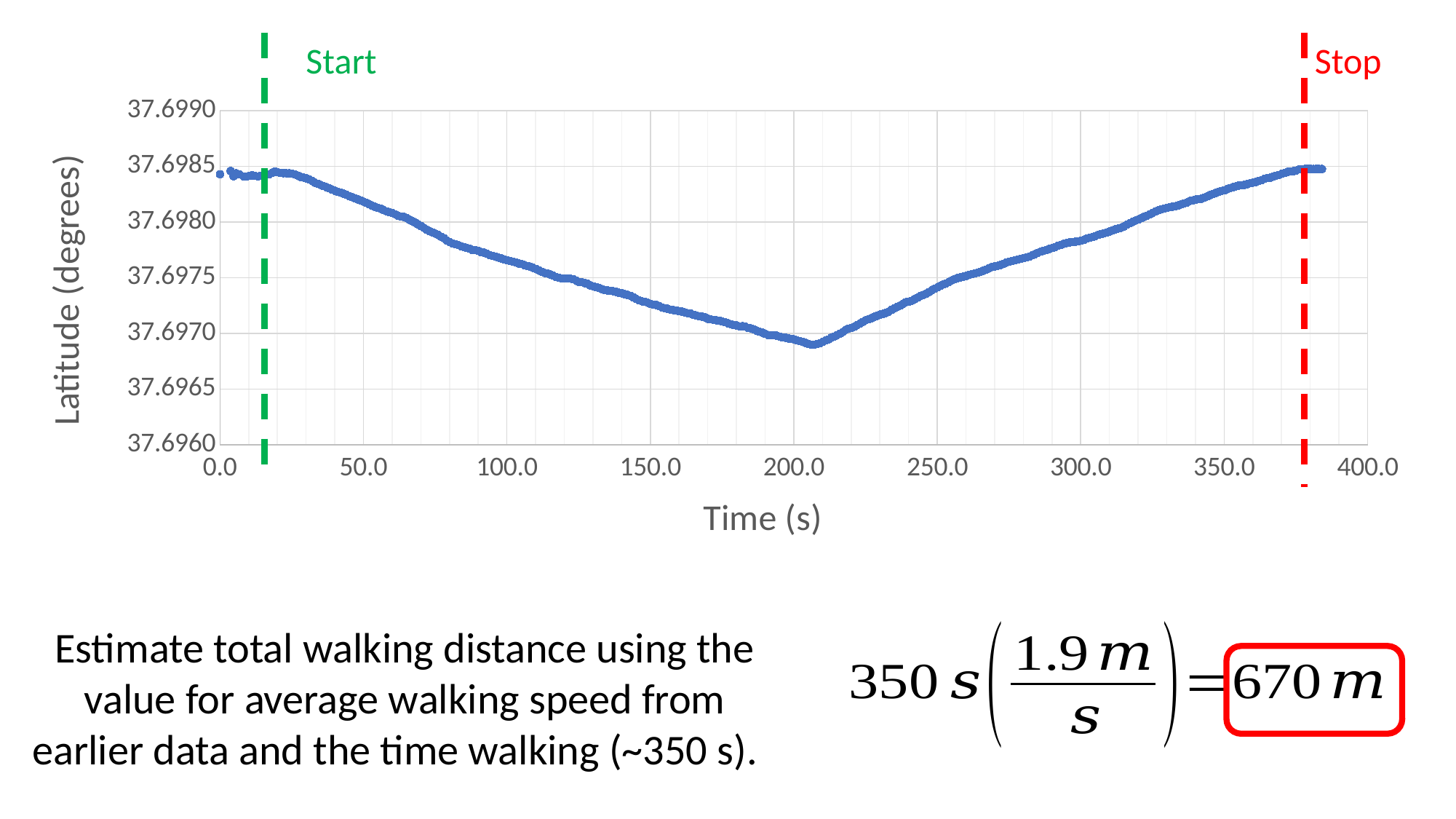
What kind of chart is shown on the slide? scatter chart Does the latitude rise or fall along the x axis between 250.0 s and 350.0 s? rise Is the latitude at 350.0 s greater or less than 37.6980? greater What is the label of the y axis? Latitude (degrees) What is the label of the x axis? Time (s) Which is larger, the latitude at 100.0 s or the latitude at 200.0 s? the latitude at 100.0 s Is the latitude at 100.0 s greater or less than 37.6975? greater Does the latitude rise or fall along the x axis between 0.0 s and 200.0 s? fall Is the latitude at 50.0 s greater or less than 37.6980? greater Near which x-axis tick does the latitude reach its lowest value? 200.0